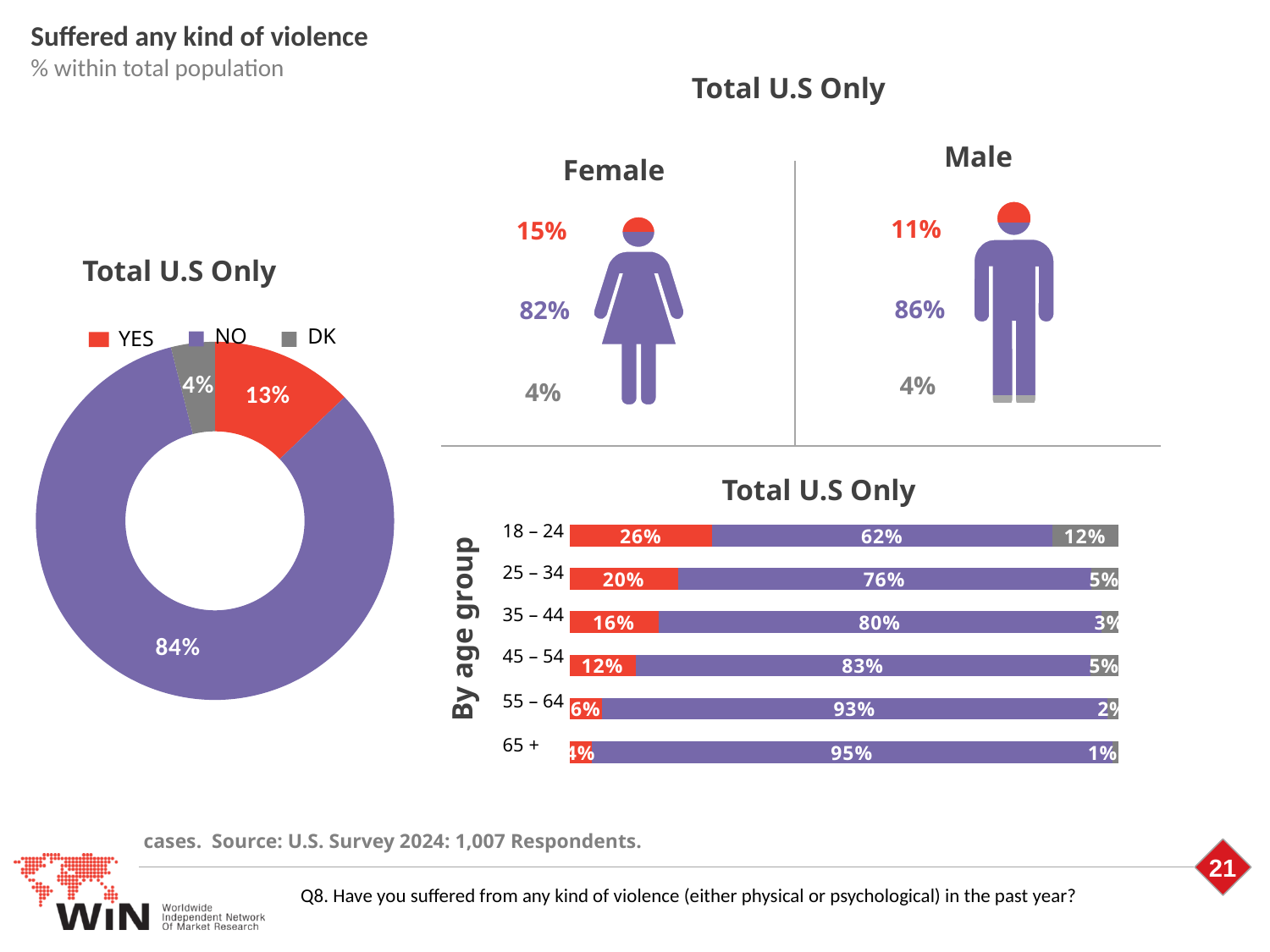
In the donut chart on the left, what percentage answered YES? 13% In the donut chart on the left, which response has the largest share? NO What kind of chart is the chart on the left of the slide? Donut chart In the stacked bar chart by age group at the bottom right, what is the NO percentage for the 55 – 64 group? 93% In the stacked bar chart by age group at the bottom right, what is the YES percentage for the 18 – 24 group? 26% In the donut chart on the left, which response has the smallest share? DK How many entries does the legend of the donut chart on the left list? 3 In the stacked bar chart by age group at the bottom right, does the YES percentage rise or fall as age increases from 18 – 24 to 65 +? Fall In the donut chart on the left, what percentage answered NO? 84% In the stacked bar chart by age group at the bottom right, what is the difference between the YES percentages of the 18 – 24 and 45 – 54 groups? 14% In the stacked bar chart by age group at the bottom right, which age group has the highest YES percentage? 18 – 24 In the stacked bar chart by age group at the bottom right, how many age groups are shown? 6